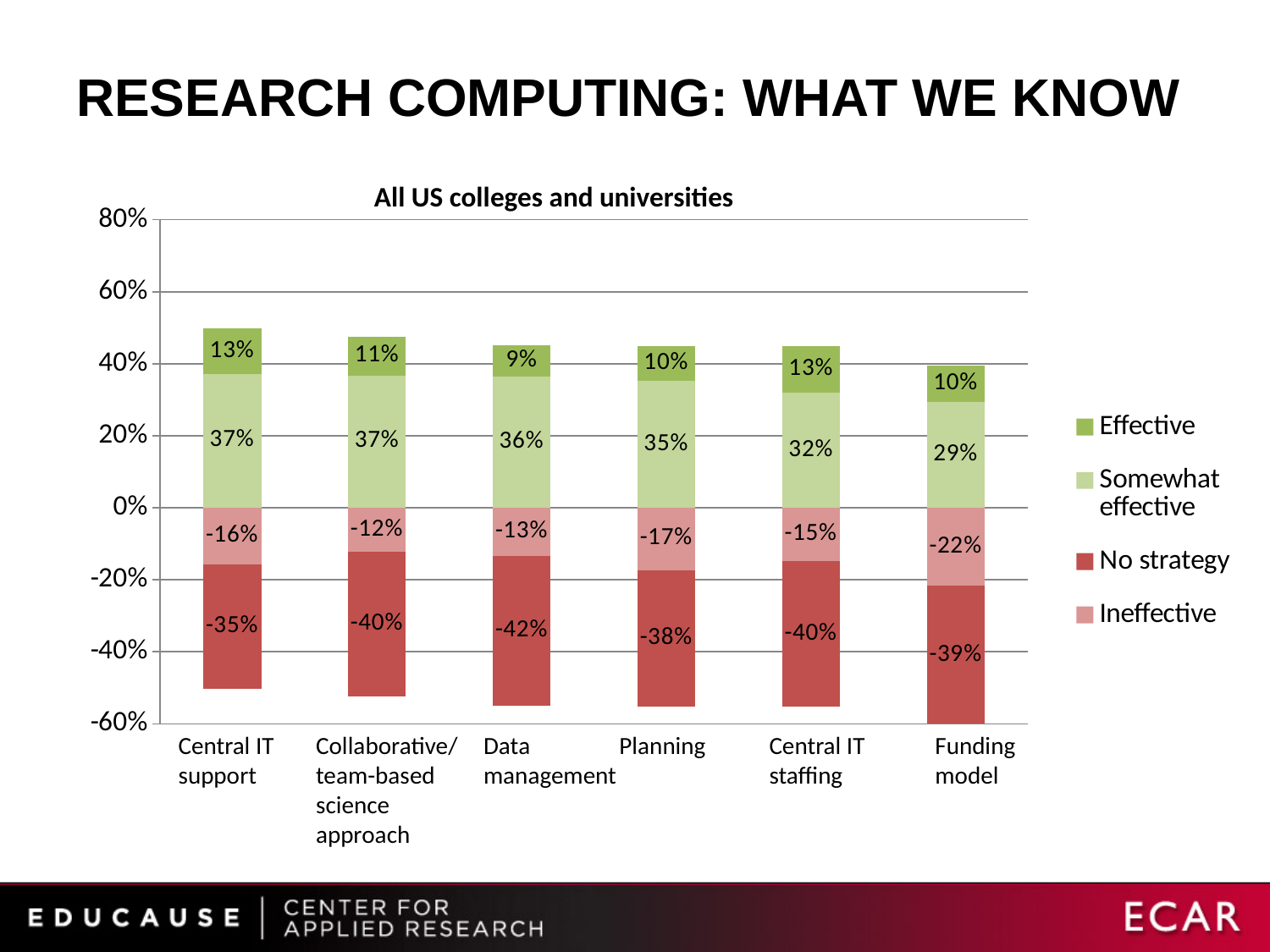
What is the No strategy value for Data management? -42% Which is larger in magnitude, the Ineffective value for Funding model or for Collaborative/team-based science approach? Funding model Which category has the lowest Effective value? Data management What is the title of the chart? All US colleges and universities How many series does the legend list? 4 How many categories are shown on the x axis? 6 Which category has the highest Somewhat effective value? Central IT support and Collaborative/team-based science approach (both 37%) What kind of chart is this? Stacked bar chart What is the Effective value for Central IT support? 13% What is the difference between the Somewhat effective values for Central IT support and Funding model? 8 percentage points What is the Ineffective value for Planning? -17% What is the Somewhat effective value for Funding model? 29%